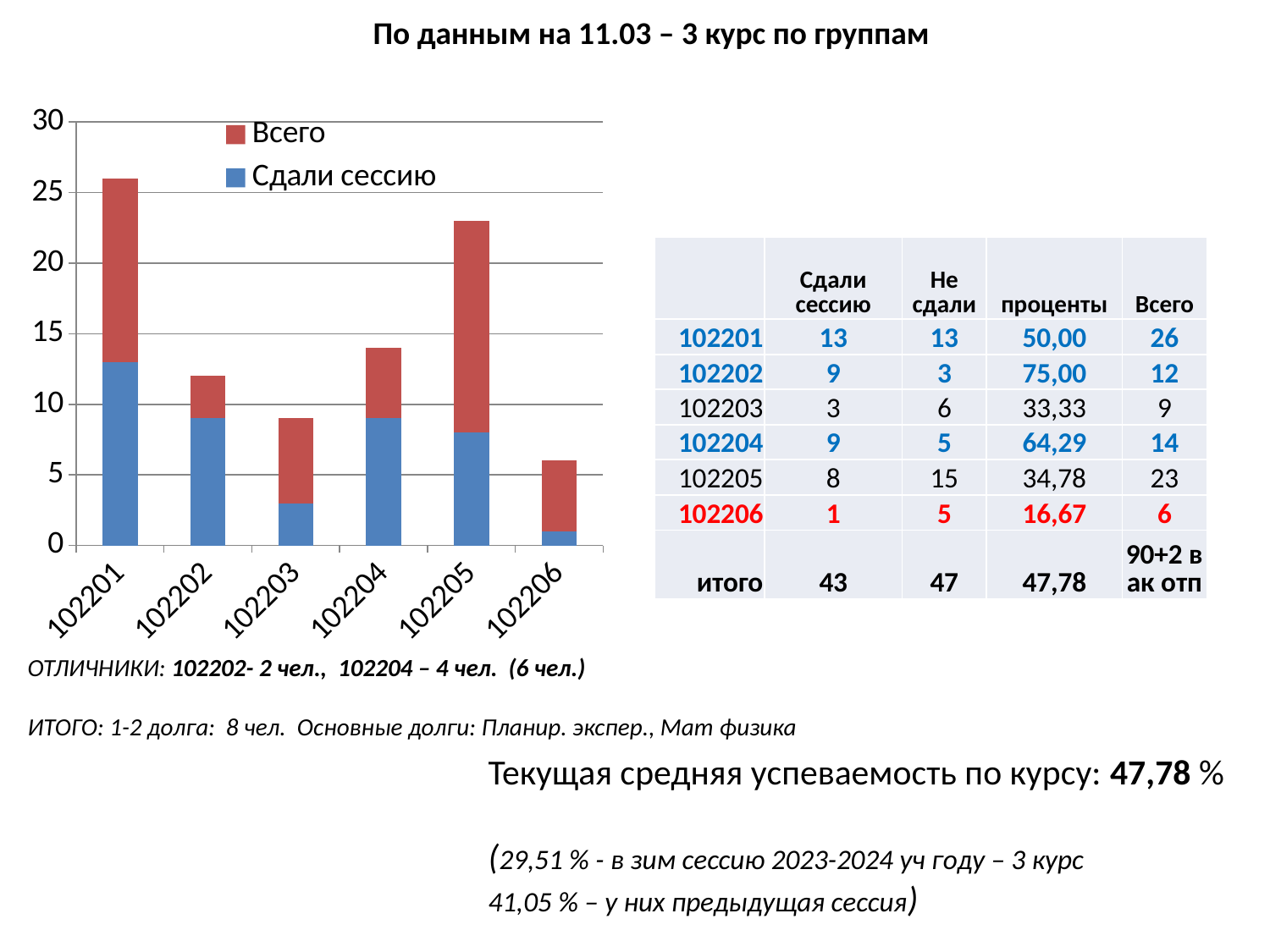
What is the 'Сдали сессию' value for group 102201? 13 Which group has the larger blue 'Сдали сессию' segment, 102201 or 102205? 102201 Is the top of the bar for group 102203 greater or less than 10? less What kind of chart is shown on the slide? Stacked bar chart How many groups (categories) are shown on the x axis of the chart? 6 Is the top of the bar for group 102205 greater or less than 20? greater Is the blue 'Сдали сессию' segment for group 102206 greater or less than 5? less How many series does the chart legend list? 2 What are the two entries in the chart legend? Всего, Сдали сессию What is the 'Всего' value for group 102205? 23 Which group has the tallest bar in the chart? 102201 Which group has the shortest bar in the chart? 102206